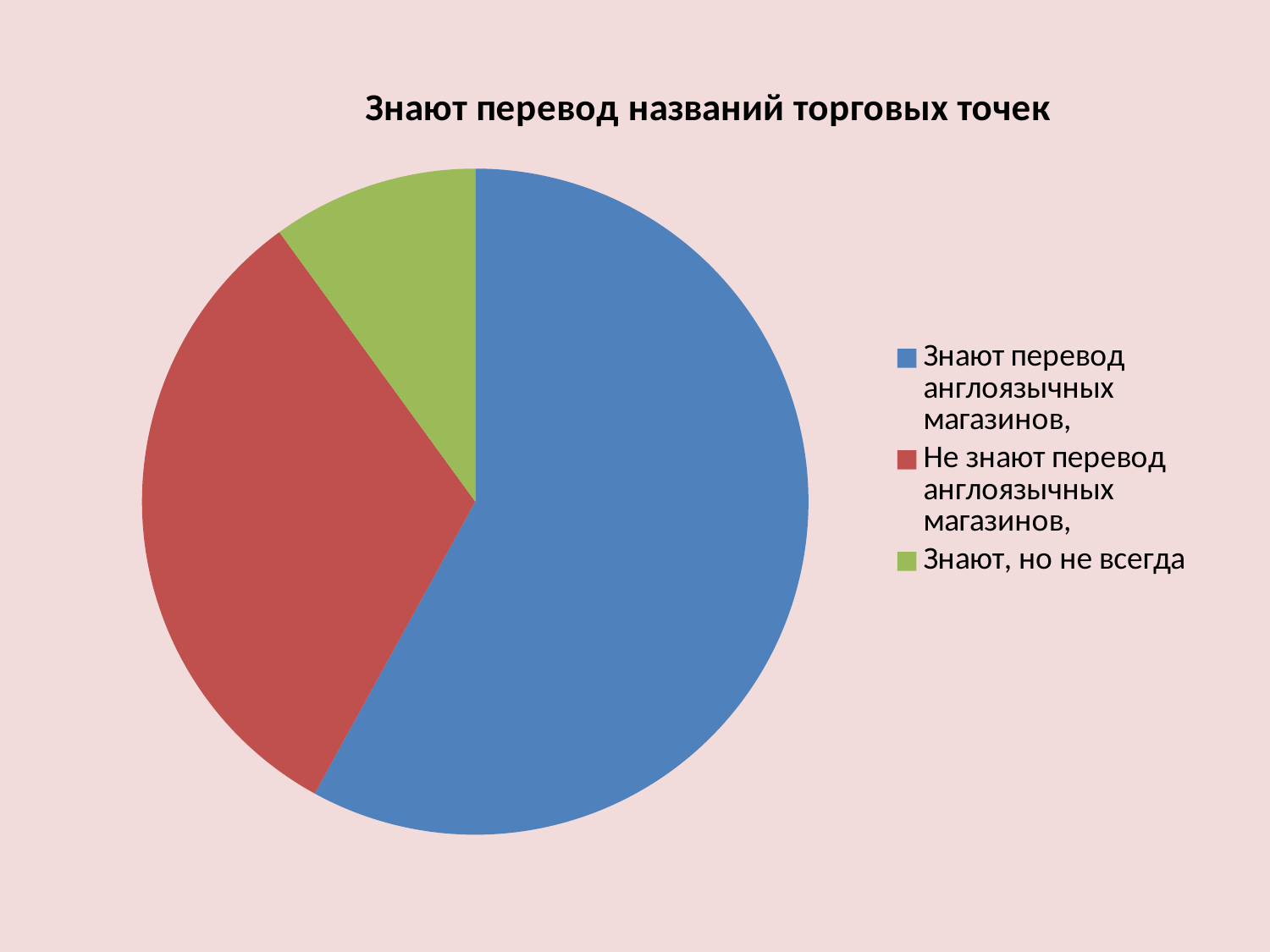
What is the title of the chart? Знают перевод названий торговых точек Which slice is larger: "Знают перевод англоязычных магазинов" or "Не знают перевод англоязычных магазинов"? Знают перевод англоязычных магазинов What colour is the slice for "Знают, но не всегда"? green Which category has the largest slice of the pie? Знают перевод англоязычных магазинов Which category has the smallest slice of the pie? Знают, но не всегда What kind of chart is shown on the slide? pie chart How many slices does the pie chart have? 3 How many entries does the legend list? 3 Which slice is larger: "Не знают перевод англоязычных магазинов" or "Знают, но не всегда"? Не знают перевод англоязычных магазинов